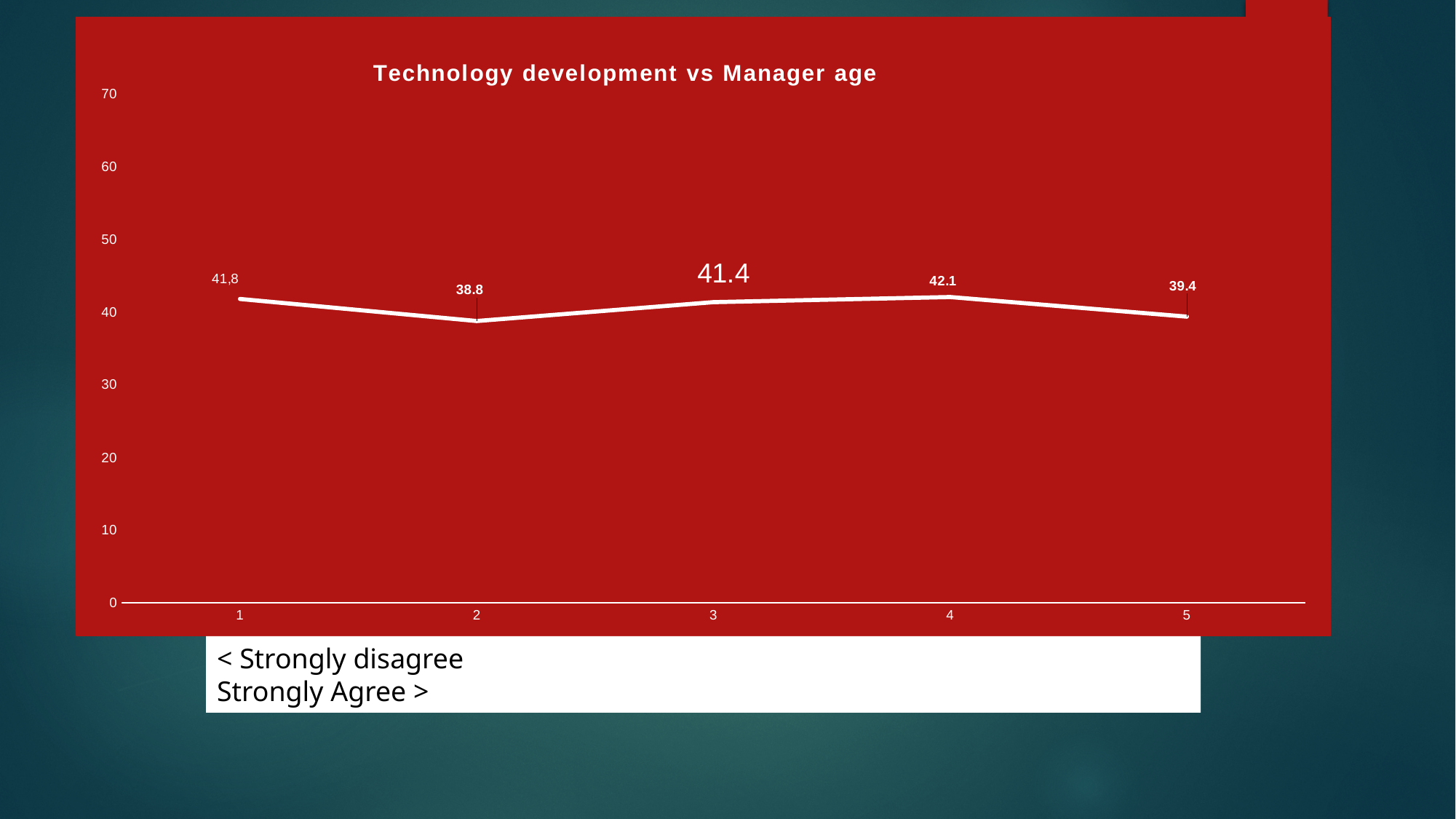
What is the value at category 4? 42.1 What is the difference between the values at category 4 and category 2? 3.3 What type of chart is shown on the slide? line chart What is the title of the chart? Technology development vs Manager age What is the value at category 1? 41,8 Which category has the lowest value? 2 How many categories are plotted on the x axis? 5 Which is larger, the value at category 4 or the value at category 5? category 4 What is the value at category 2? 38.8 Which category has the highest value? 4 What is the value at category 5? 39.4 What is the value at category 3? 41.4